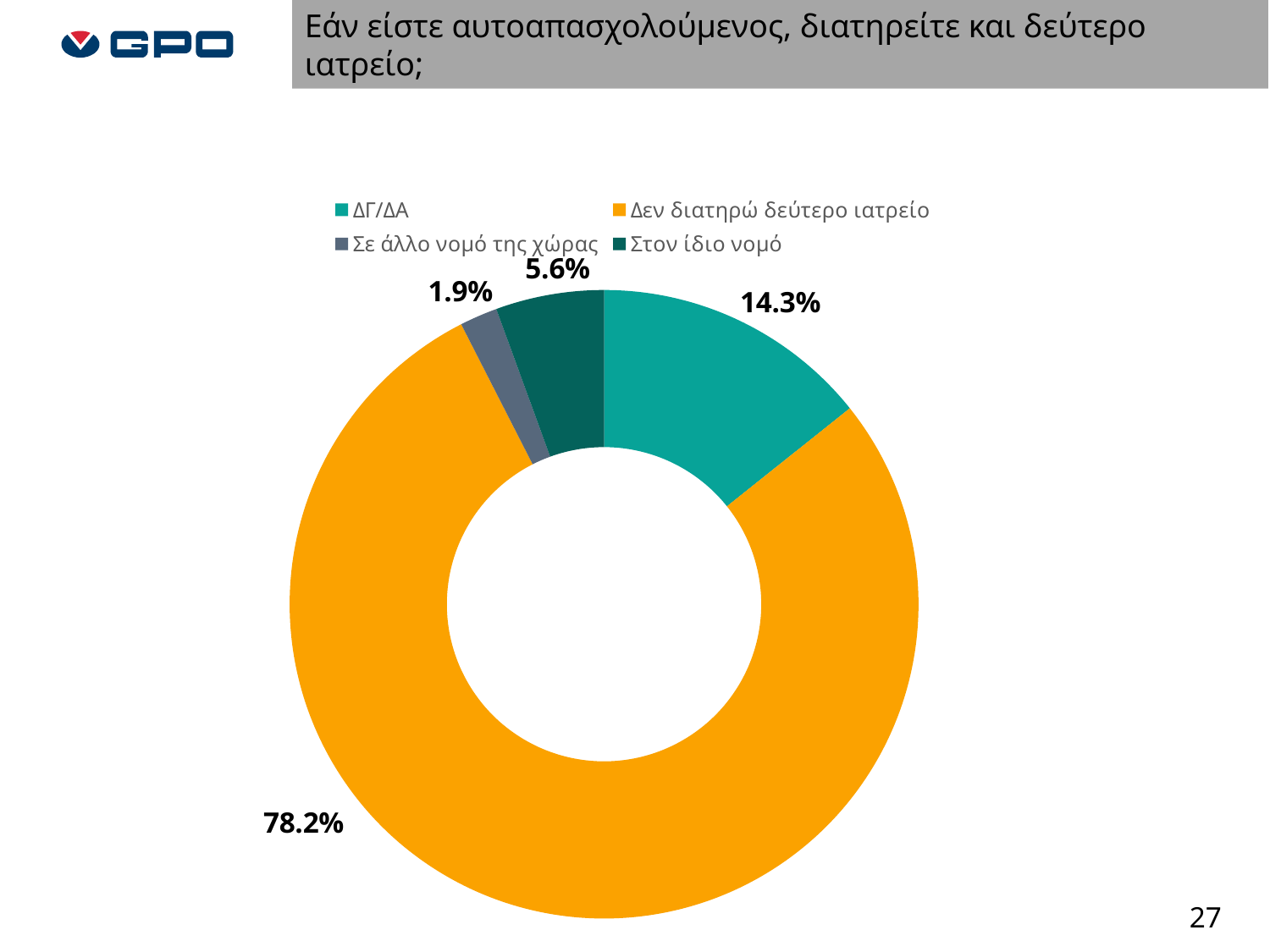
Which category has the smallest share of the chart? Σε άλλο νομό της χώρας Which is larger: the share for 'ΔΓ/ΔΑ' or the share for 'Στον ίδιο νομό'? ΔΓ/ΔΑ What kind of chart is shown on the slide? Doughnut (pie) chart What percentage of respondents answered 'Δεν διατηρώ δεύτερο ιατρείο'? 78.2% What percentage of respondents answered 'ΔΓ/ΔΑ'? 14.3% What percentage of respondents answered 'Στον ίδιο νομό'? 5.6% Which category has the largest share of the chart? Δεν διατηρώ δεύτερο ιατρείο What colour is the slice for 'Δεν διατηρώ δεύτερο ιατρείο'? Orange What is the combined share of 'Στον ίδιο νομό' and 'Σε άλλο νομό της χώρας'? 7.5% How many categories are shown in the chart? 4 What is the difference in percentage points between 'Στον ίδιο νομό' and 'Σε άλλο νομό της χώρας'? 3.7 What percentage of respondents answered 'Σε άλλο νομό της χώρας'? 1.9%